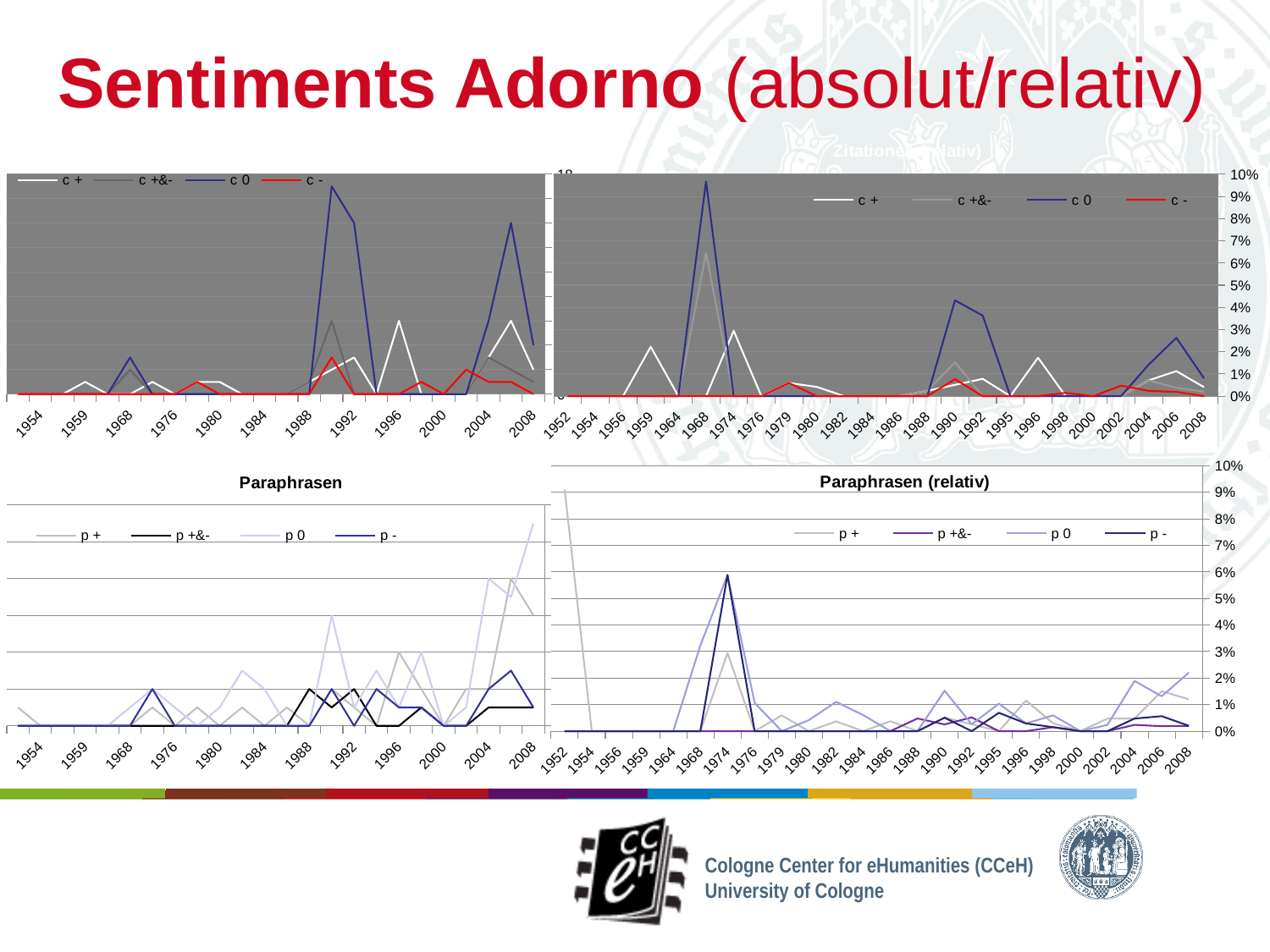
What kind of chart is the bottom-left chart titled "Paraphrasen"? line chart In the bottom-right chart "Paraphrasen (relativ)", is the value for p - in 1974 greater or less than 5%? greater In the bottom-right chart "Paraphrasen (relativ)", in which year does the p - series reach its highest value? 1974 How many series does the legend of the top-left chart list? 4 In the top-right chart, is the value for c 0 in 1968 greater or less than 5%? greater In the top-right chart, is the value for c 0 in 1990 greater or less than 3%? greater In the top-right chart, in which year does the c 0 series reach its highest value? 1968 In the top-right chart, which is larger in 1968: the value for c 0 or the value for c -? c 0 In the bottom-right chart "Paraphrasen (relativ)", which series is drawn in the darkest (black) line according to the legend? p - How many series does the legend of the bottom-right chart "Paraphrasen (relativ)" list? 4 In the top-right chart, which series is drawn in red according to the legend? c -